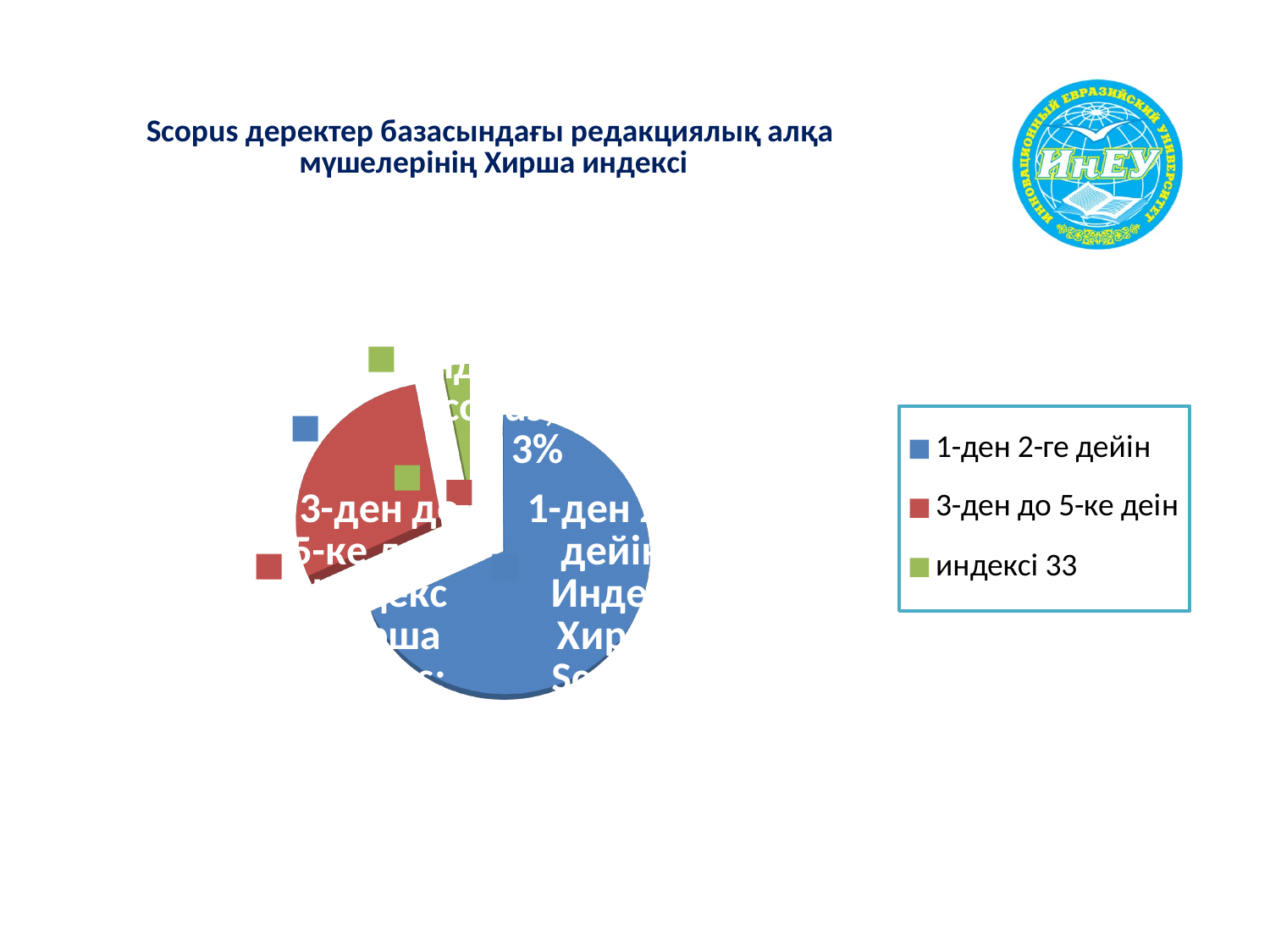
What share of the pie does the 'индексі 33' slice represent? 3% What kind of chart is shown on the slide? pie chart Is the share of the 'индексі 33' slice greater or less than 10%? less Which category has the smallest slice of the pie chart? индексі 33 How many categories does the legend of the pie chart list? 3 What is the title of the chart on the slide? Scopus деректер базасындағы редакциялық алқа мүшелерінің Хирша индексі Which slice is larger: '3-ден до 5-ке деін' or 'индексі 33'? 3-ден до 5-ке деін Which slice is larger: '1-ден 2-ге дейін' or '3-ден до 5-ке деін'? 1-ден 2-ге дейін Which category has the largest slice of the pie chart? 1-ден 2-ге дейін What colour is the slice for '1-ден 2-ге дейін' in the pie chart? blue